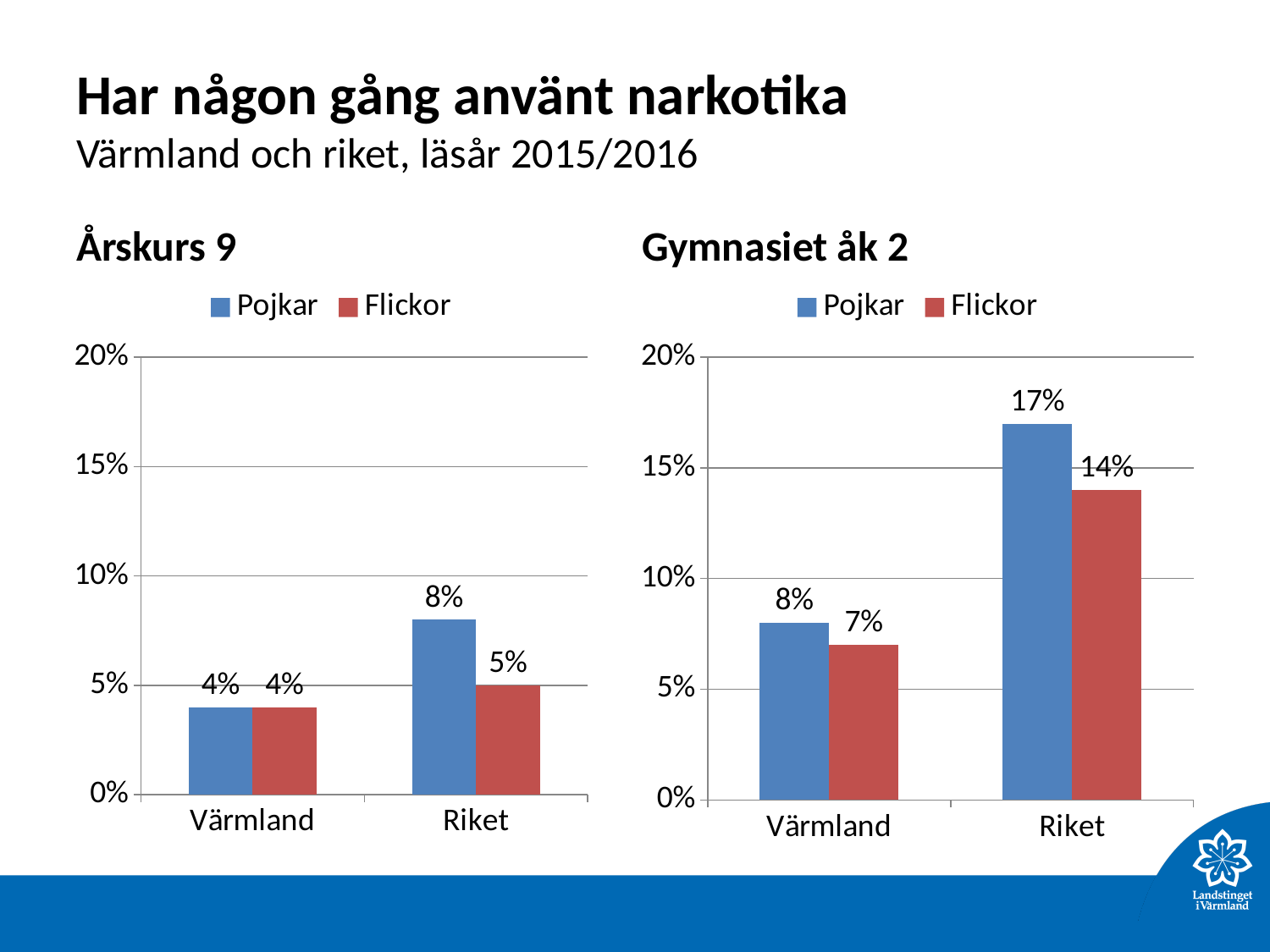
In the Gymnasiet åk 2 chart, is the value for Flickor in Riket greater or less than 10%? greater In the Årskurs 9 chart, what is the difference between Pojkar and Flickor in Riket? 3% How many categories are shown on the x axis of the Gymnasiet åk 2 chart? 2 In the Gymnasiet åk 2 chart, what is the value for Pojkar in Värmland? 8% In the Gymnasiet åk 2 chart, what is the value for Flickor in Riket? 14% What kind of chart is the Årskurs 9 chart? Bar chart In the Gymnasiet åk 2 chart, what is the difference between Pojkar in Riket and Pojkar in Värmland? 9% In the Gymnasiet åk 2 chart, which bar is the highest? Pojkar, Riket In the Gymnasiet åk 2 chart, which is larger in Värmland, Pojkar or Flickor? Pojkar How many series does the legend of the Årskurs 9 chart list? 2 In the Årskurs 9 chart, what is the value for Pojkar in Riket? 8% In the Årskurs 9 chart, what is the value for Flickor in Värmland? 4%